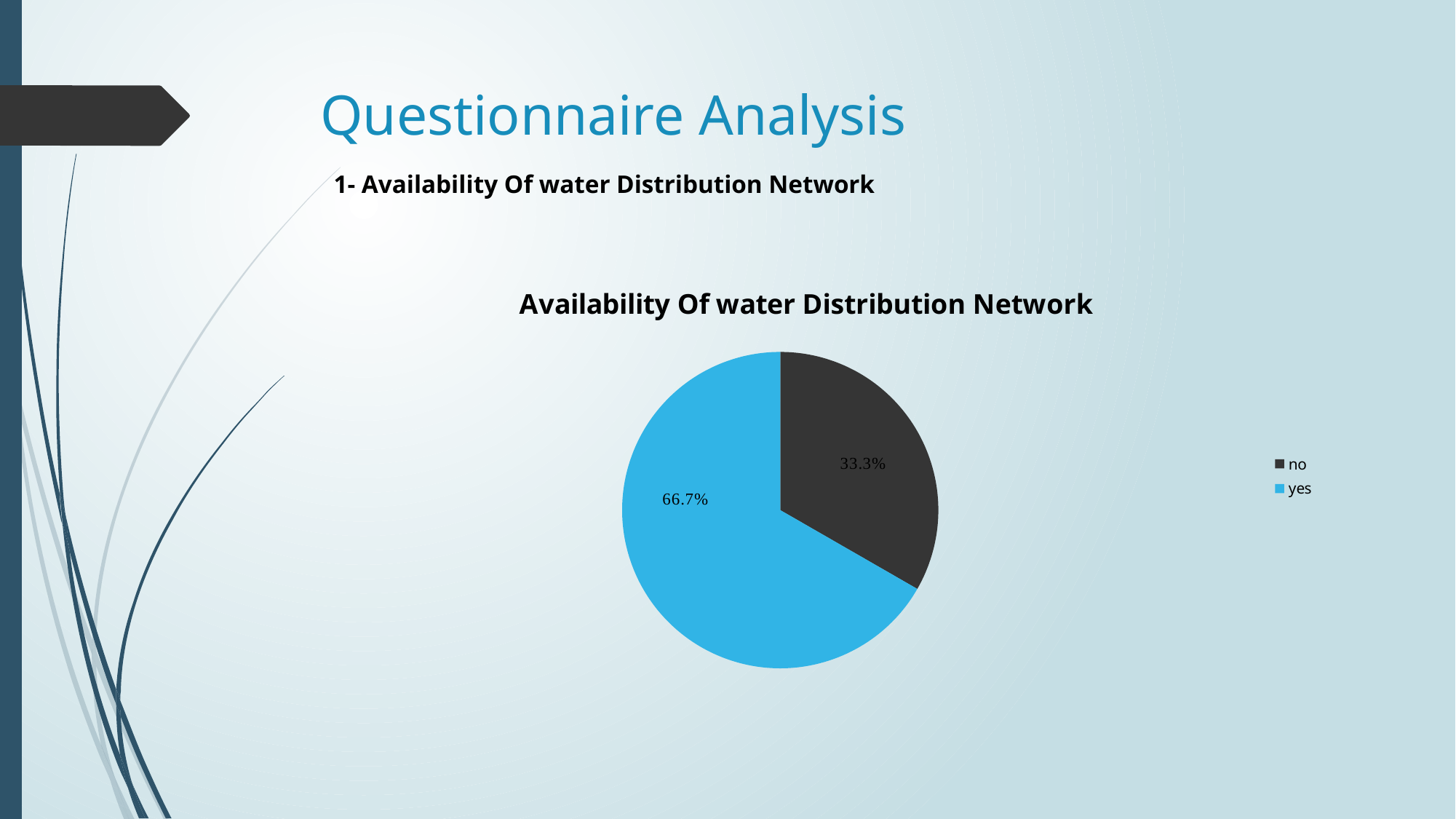
Which is larger, the "yes" slice or the "no" slice? yes How many entries does the legend list? 2 What is the difference in percentage points between the "yes" and "no" slices? 33.4% What share of the pie does the "yes" slice represent? 66.7% What share of the pie does the "no" slice represent? 33.3% Which slice is the largest in the pie chart? yes Which slice is the smallest in the pie chart? no How many slices does the pie chart have? 2 What kind of chart is shown on the slide? pie chart What colour is the "yes" slice in the pie chart? light blue What is the title of the chart? Availability Of water Distribution Network